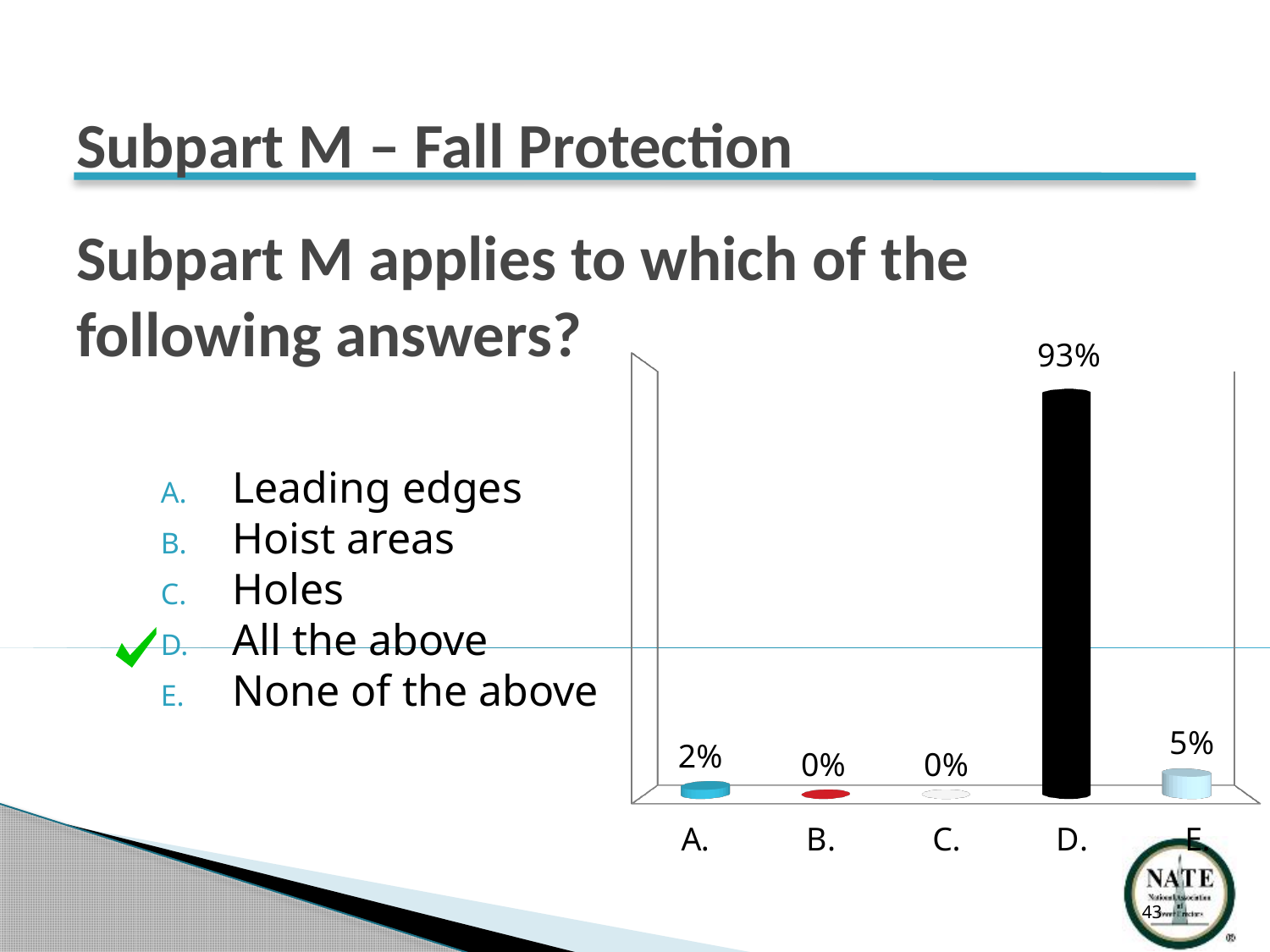
What is the value for category A. in the chart? 2% What is the value for category B. in the chart? 0% Which is larger, the value for A. or the value for E.? E. What is the value for category D. in the chart? 93% What is the value for category E. in the chart? 5% What is the difference between the values for D. and E.? 88% How many categories in the chart have a value of 0%? 2 Which category has the highest value in the chart? D. What is the difference between the values for E. and A.? 3% What kind of chart is shown on the slide? bar chart How many categories are shown on the x axis of the chart? 5 What colour is the bar for category D.? black